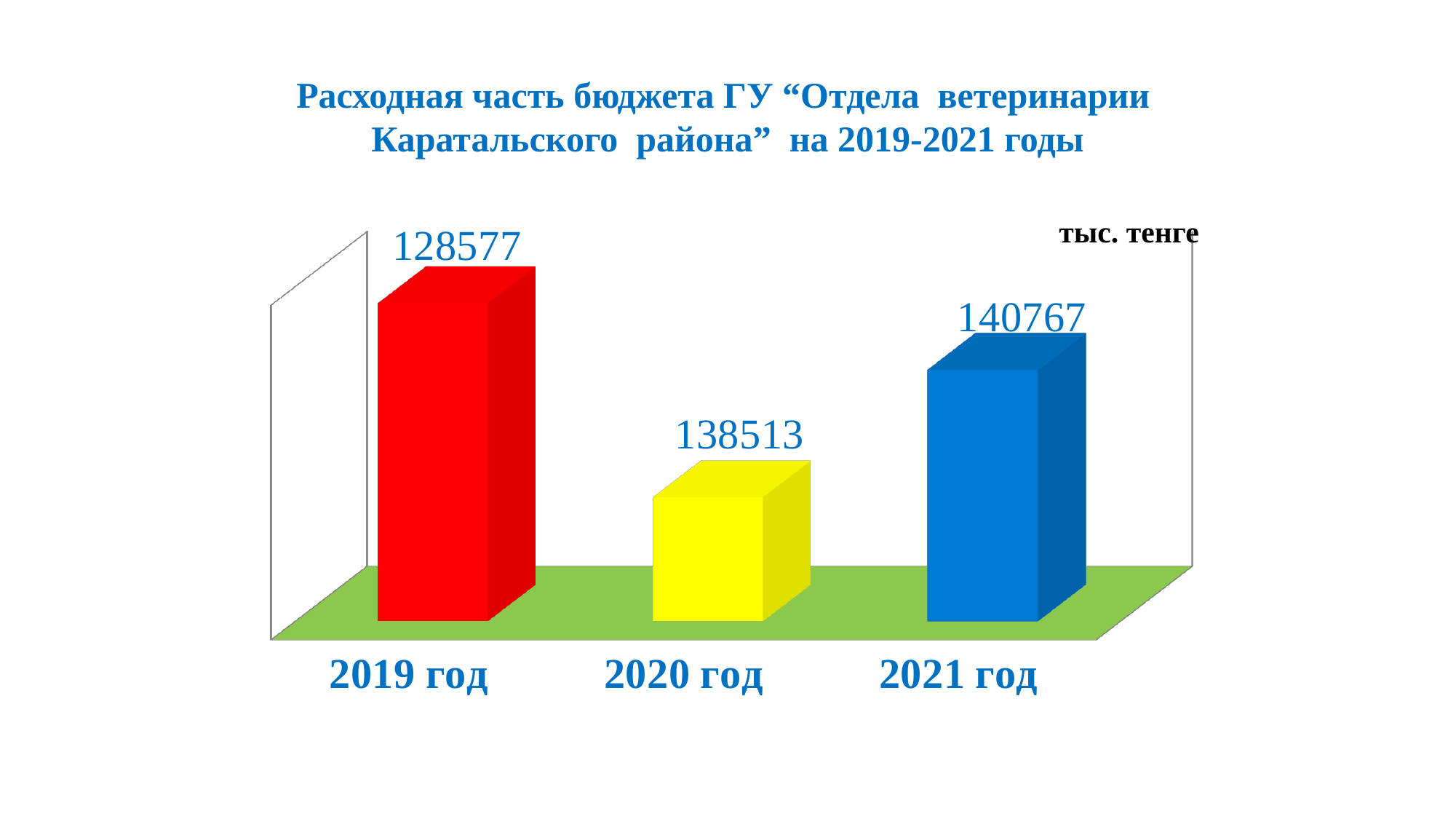
How many years are shown on the chart? 3 What is the difference between the labelled values for 2021 год and 2020 год? 2254 What is the difference between the labelled values for 2021 год and 2019 год? 12190 What is the value for 2019 год? 128577 What is the difference between the labelled values for 2020 год and 2019 год? 9936 What is the value for 2021 год? 140767 What colour is the bar for 2020 год? yellow What is the value for 2020 год? 138513 What unit is indicated for the values on the chart? тыс. тенге What kind of chart is shown on the slide? bar chart